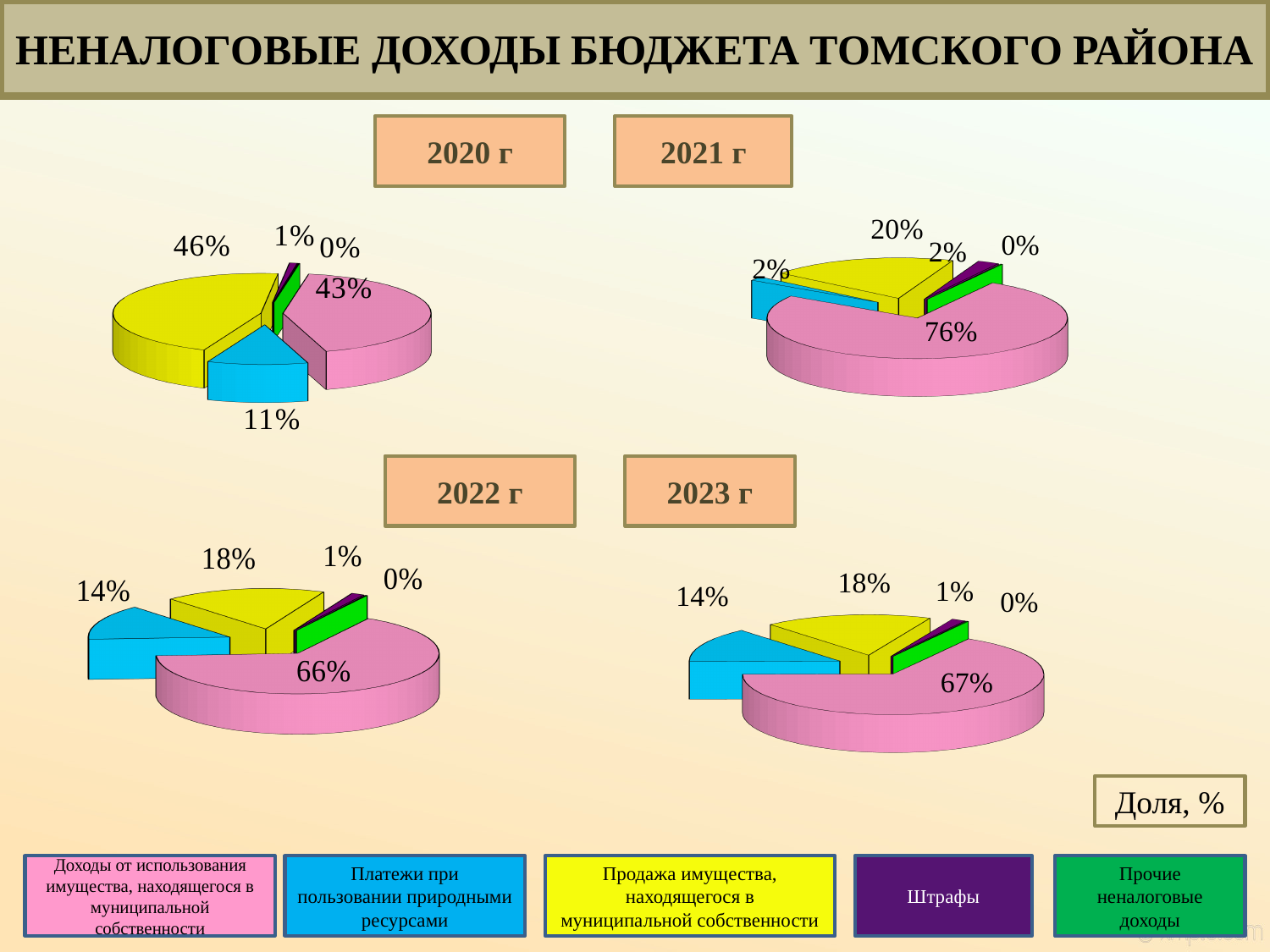
What share is shown for the green slice (Прочие неналоговые доходы) in the 2023 г pie chart? 0% How many categories does the legend at the bottom of the slide list? 5 What type of charts are shown on the slide? Pie charts In the 2020 г pie chart, which is larger: the yellow slice or the pink slice? The yellow slice (46%) In the 2023 г pie chart, what share is shown for the pink slice (Доходы от использования имущества, находящегося в муниципальной собственности)? 67% In the 2020 г pie chart, what share is shown for the blue slice (Платежи при пользовании природными ресурсами)? 11% In the 2022 г pie chart, what share is shown for the yellow slice (Продажа имущества, находящегося в муниципальной собственности)? 18% In the 2020 г pie chart, what share is shown for the yellow slice (Продажа имущества, находящегося в муниципальной собственности)? 46% What is the difference between the pink slice's share in the 2021 г chart (76%) and in the 2020 г chart (43%)? 33% In the 2021 г pie chart, which category has the largest share? Доходы от использования имущества, находящегося в муниципальной собственности In the 2021 г pie chart, what share is shown for the pink slice (Доходы от использования имущества, находящегося в муниципальной собственности)? 76% How many pie charts are on the slide? 4